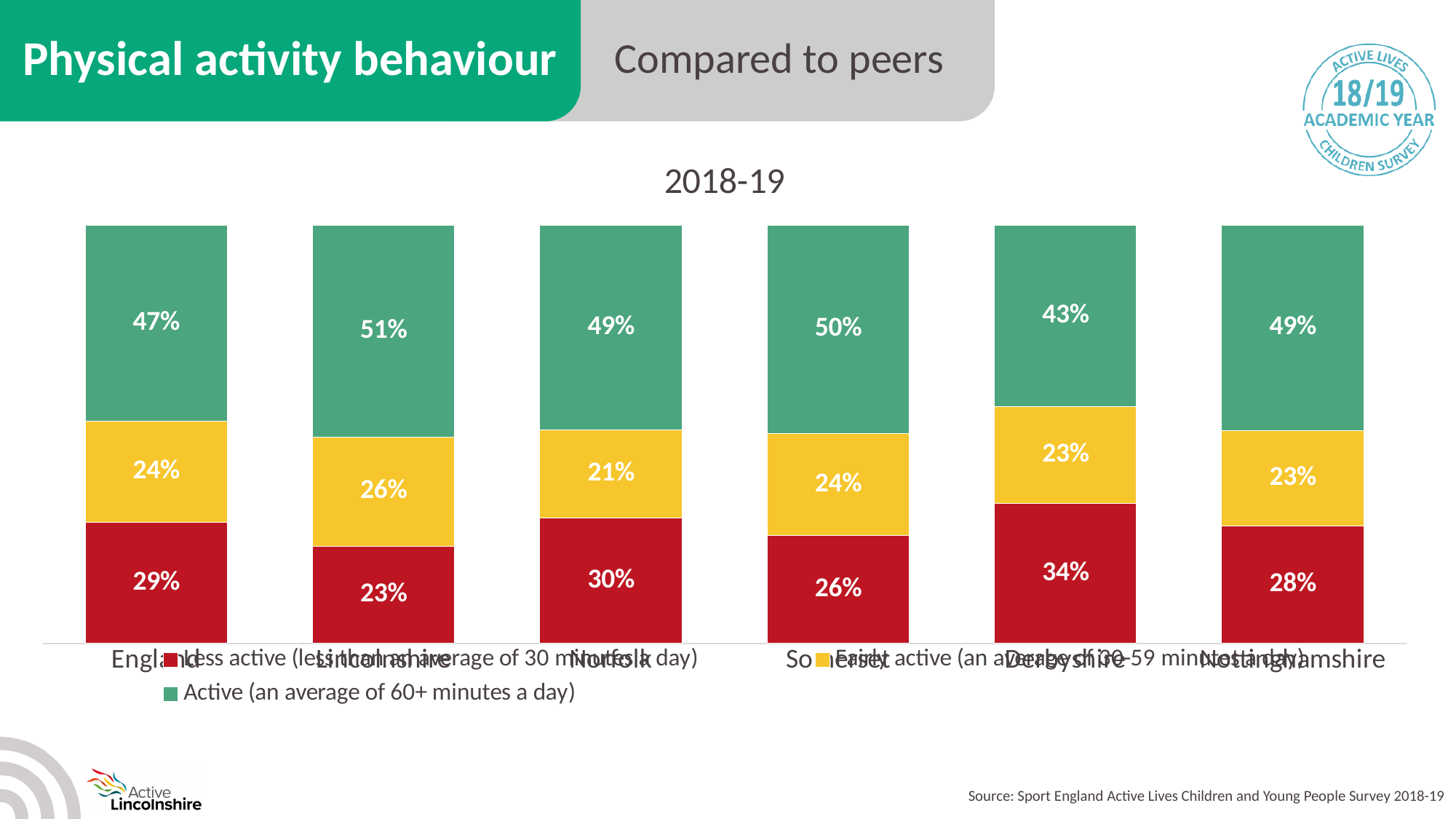
What is the difference between the Active and Less active percentages for England? 18 percentage points How many areas (categories) are plotted along the x axis of the chart? 6 What is the title shown above the chart? 2018-19 What is the Less active value for Norfolk? 30% Which area has the highest Active (60+ minutes a day) percentage? Lincolnshire Which area has the highest Less active percentage? Derbyshire Which area has the lowest Active (60+ minutes a day) percentage? Derbyshire How many series does the chart's legend list? 3 What percentage of children in England are Active (an average of 60+ minutes a day)? 47% Which has a higher Less active percentage, England or Nottinghamshire? England What kind of chart is shown on the slide? Stacked bar chart What is the Fairly active value for Lincolnshire? 26%